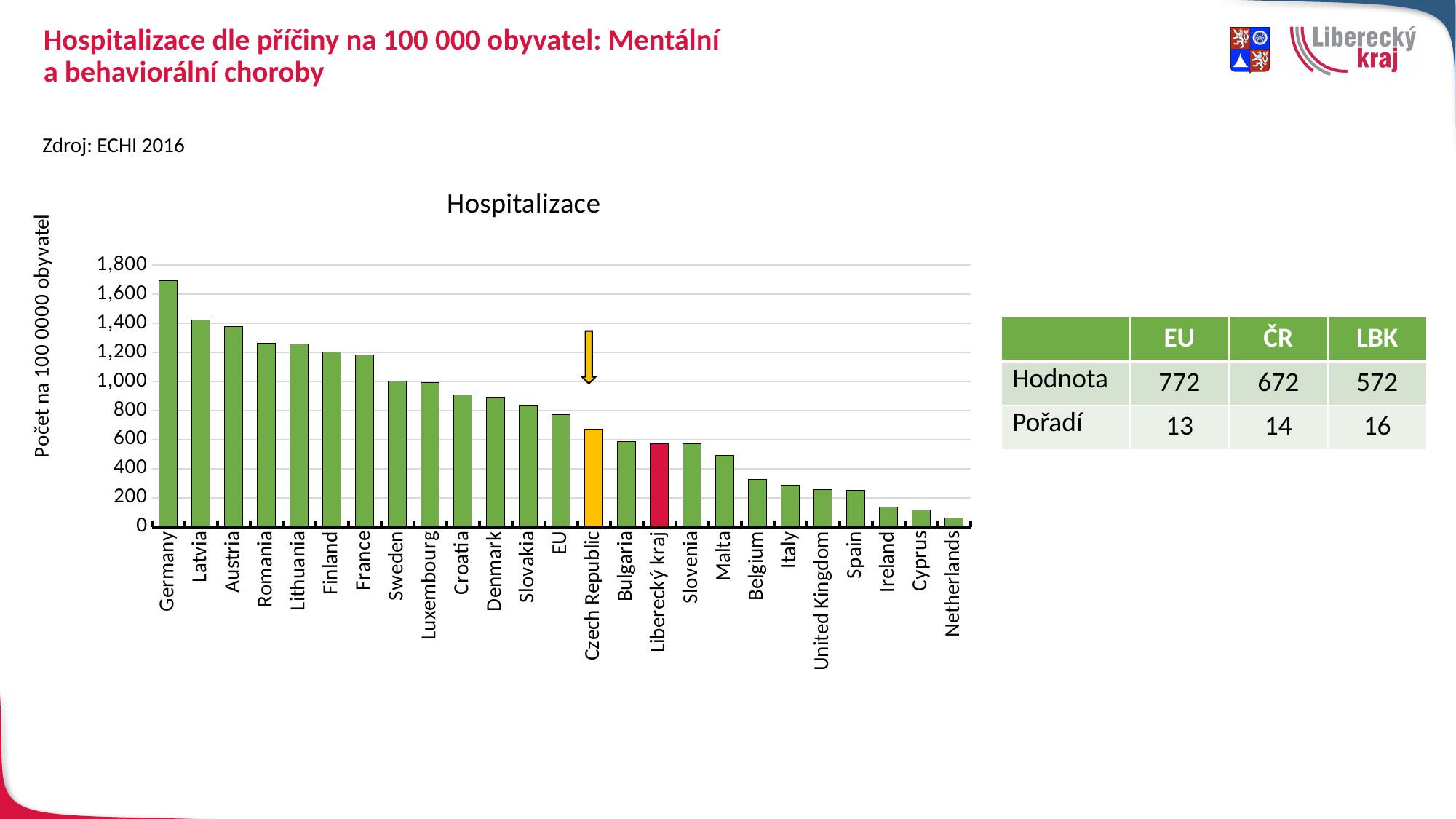
What is the hospitalization value for Liberecký kraj (LBK)? 572 Is the value for Malta greater or less than 600? less Is the value for Germany greater or less than 1,600? greater How many categories (bars) are plotted in the chart? 25 What type of chart is shown on the slide? bar chart What is the hospitalization value for the Czech Republic (ČR)? 672 Do the values rise or fall moving from left to right along the x axis? fall What is the hospitalization value for the EU? 772 Which category has the highest hospitalization value in the chart? Germany Which category has the lowest hospitalization value in the chart? Netherlands What is the title of the chart? Hospitalizace What is the difference between the EU value and the Liberecký kraj (LBK) value? 200